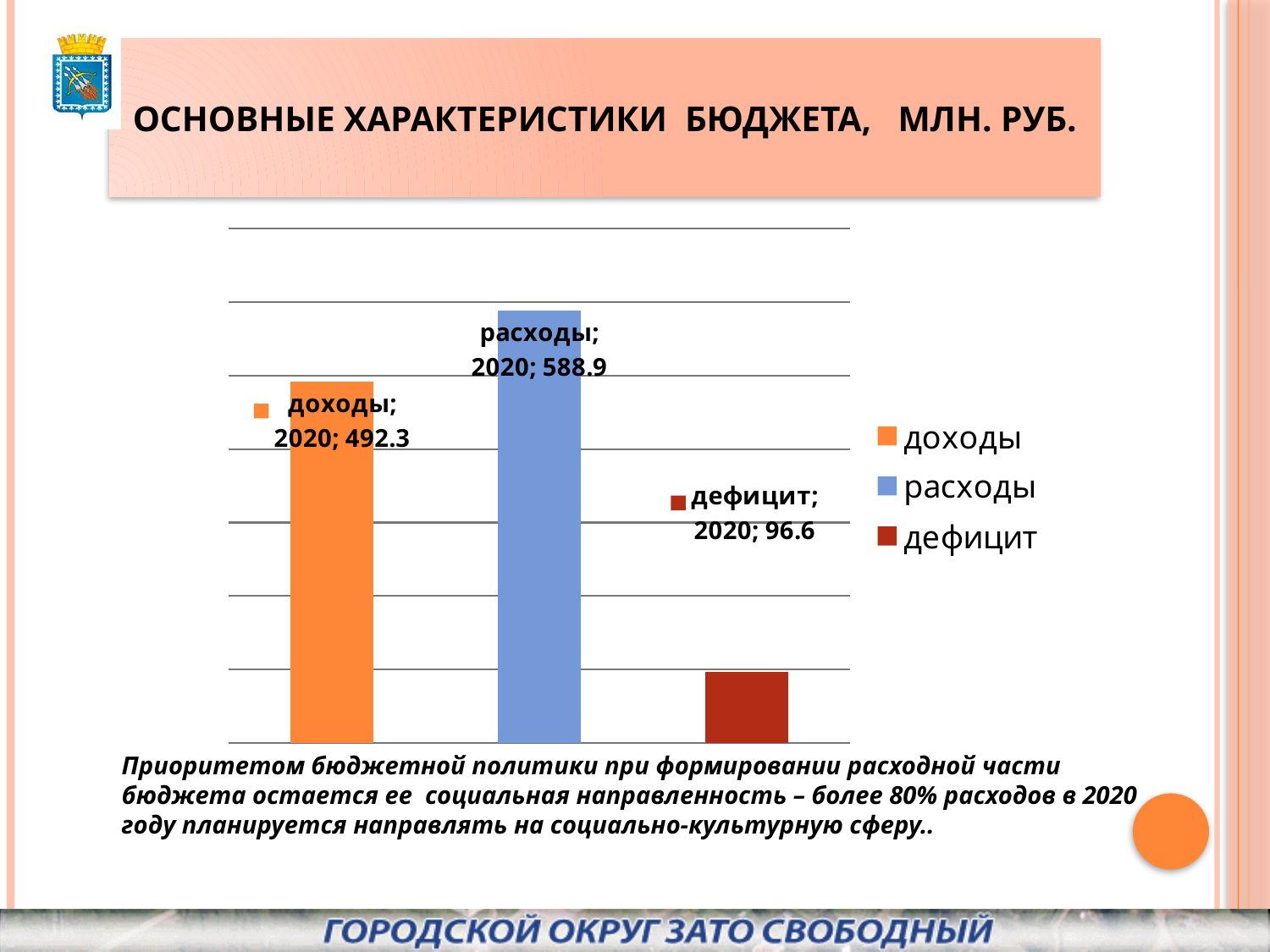
Which series has the highest value? расходы What is the difference between доходы and дефицит? 395.7 Which is larger, доходы or расходы? расходы What is the value for расходы in 2020? 588.9 How many bars are plotted in the chart? 3 Which series has the lowest value? дефицит What is the value for доходы in 2020? 492.3 What is the value for дефицит in 2020? 96.6 What is the difference between расходы and доходы? 96.6 What type of chart is shown on the slide? bar chart How many series does the legend list? 3 What colour is the bar for дефицит? dark red